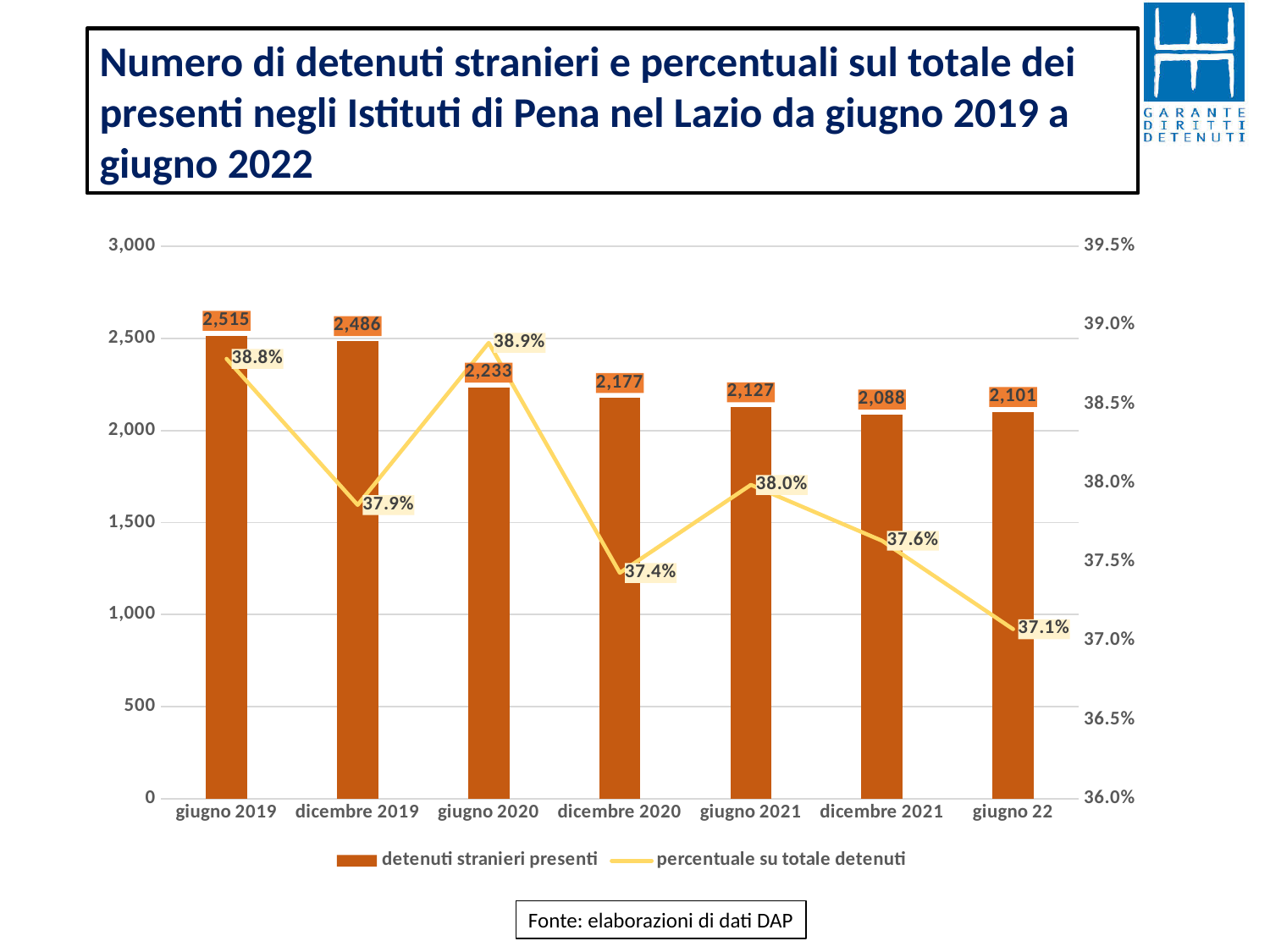
What is the value of 'detenuti stranieri presenti' for giugno 2019? 2,515 Which is larger, the number of 'detenuti stranieri presenti' in dicembre 2020 or in giugno 2021? dicembre 2020 What kind of chart is used for the 'detenuti stranieri presenti' series? bar chart What is the 'percentuale su totale detenuti' for giugno 2020? 38.9% What is the source cited below the chart? Fonte: elaborazioni di dati DAP How many periods are shown on the x axis? 7 Which period has the lowest 'percentuale su totale detenuti'? giugno 22 What is the difference in 'detenuti stranieri presenti' between giugno 2019 and giugno 22? 414 How many series does the legend list? 2 What is the value of 'detenuti stranieri presenti' for dicembre 2021? 2,088 Which period has the highest number of 'detenuti stranieri presenti'? giugno 2019 Does the number of 'detenuti stranieri presenti' generally rise or fall from giugno 2019 to dicembre 2021? fall